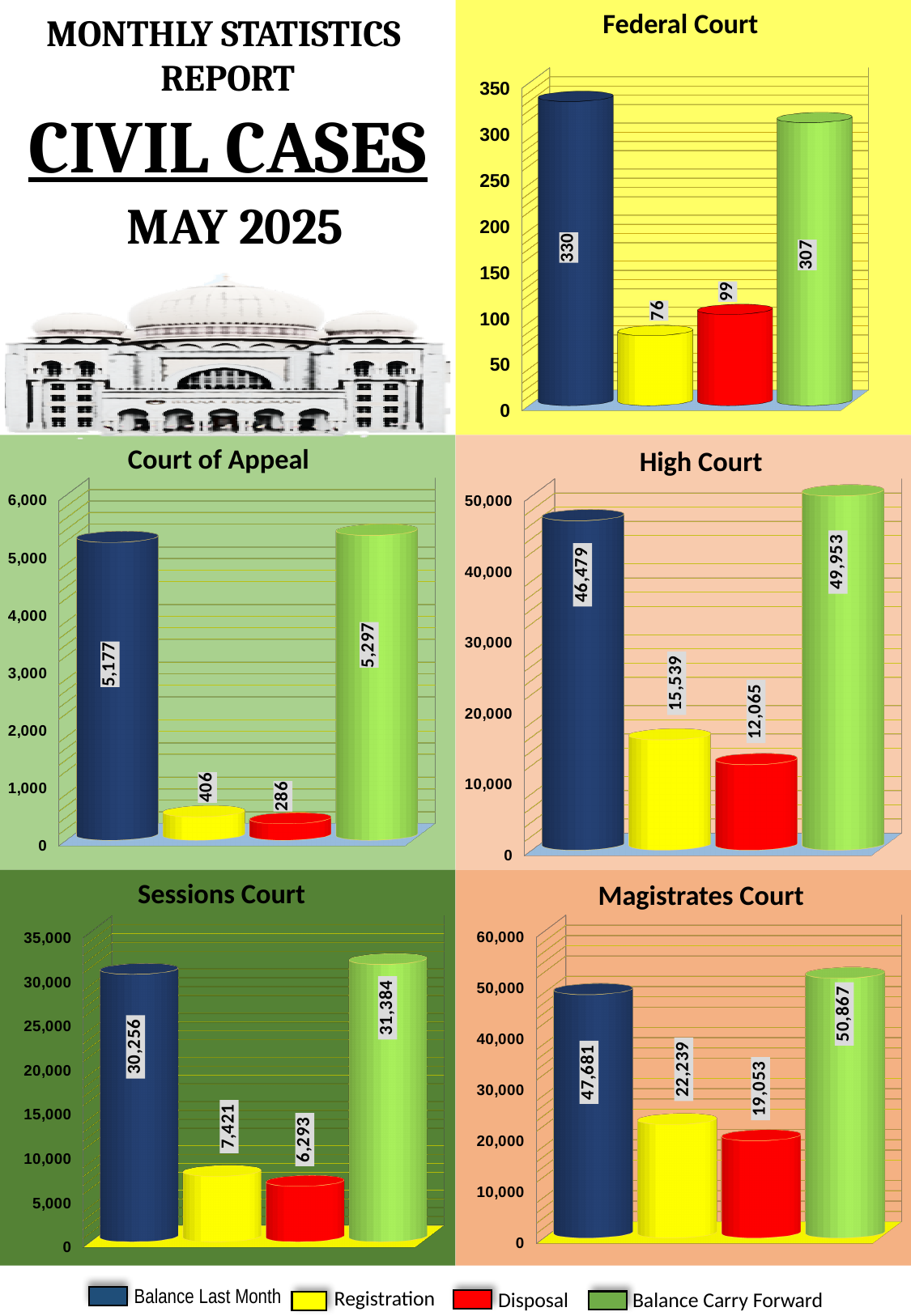
In the Court of Appeal chart, what is the value for Registration? 406 How many series does the legend at the bottom of the slide list? 4 In the Sessions Court chart, what is the value for Disposal? 6,293 What kind of chart is the Magistrates Court chart? bar chart In the Federal Court chart, what is the difference between Disposal and Registration? 23 In the Magistrates Court chart, which series has the highest value? Balance Carry Forward In the High Court chart, what is the value for Balance Carry Forward? 49,953 In the High Court chart, which is larger, Registration or Disposal? Registration In the Sessions Court chart, is the value for Balance Carry Forward greater or less than 30,000? greater In the Federal Court chart, what is the value for Balance Last Month? 330 How many charts are shown on the slide? 5 In the Court of Appeal chart, which series has the lowest value? Disposal